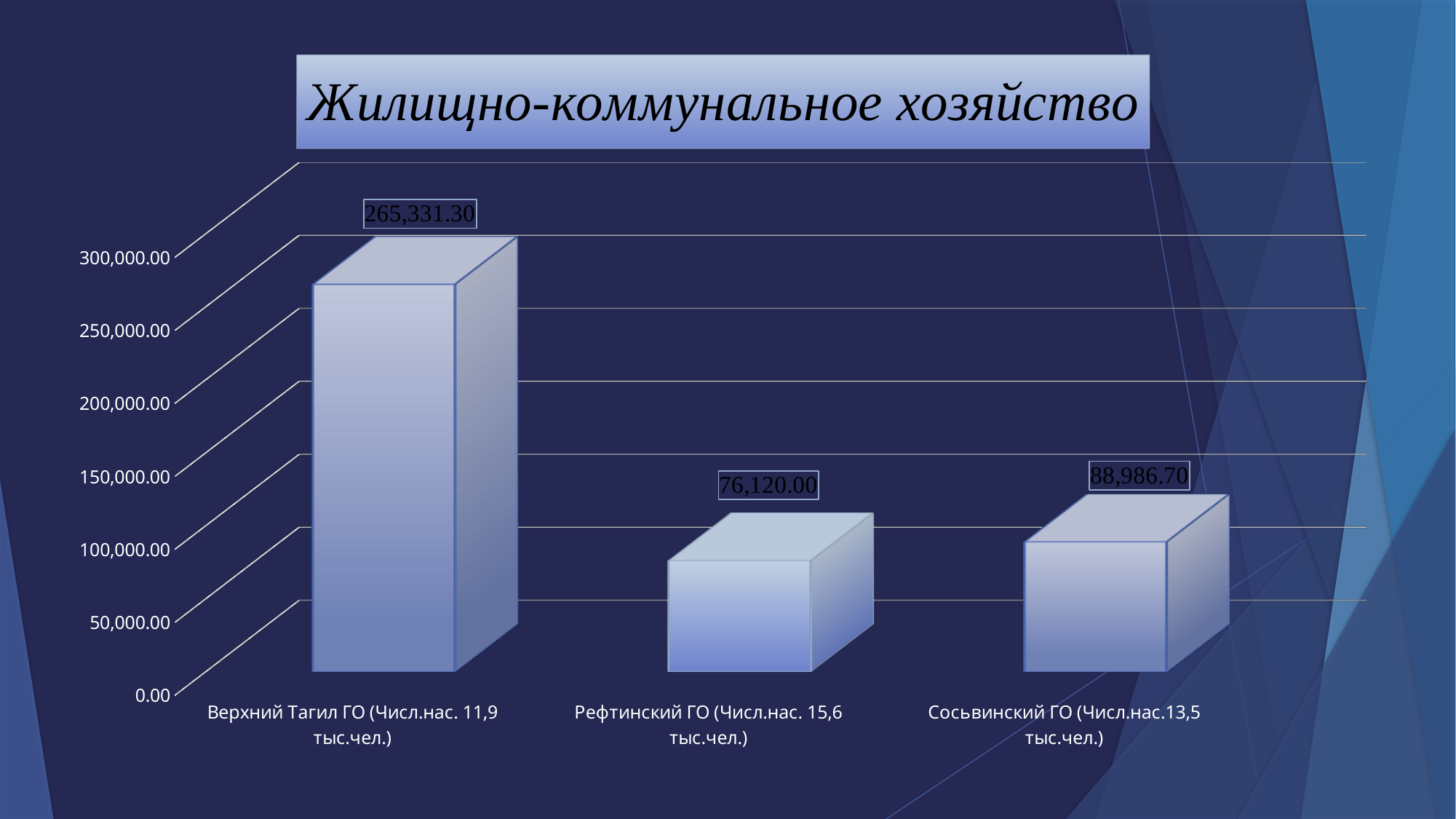
Which category has the highest value? Верхний Тагил ГО What is the value for Сосьвинский ГО? 88,986.70 Is the value for Верхний Тагил ГО greater or less than 250,000.00? greater What kind of chart is shown on the slide? bar chart Which is larger, the value for Сосьвинский ГО or the value for Рефтинский ГО? Сосьвинский ГО What is the value for Верхний Тагил ГО? 265,331.30 What is the difference between the values for Сосьвинский ГО and Рефтинский ГО? 12,866.70 How many categories are shown in the chart? 3 What is the title of the slide? Жилищно-коммунальное хозяйство What is the value for Рефтинский ГО? 76,120.00 Which category has the lowest value? Рефтинский ГО What is the difference between the values for Верхний Тагил ГО and Рефтинский ГО? 189,211.30